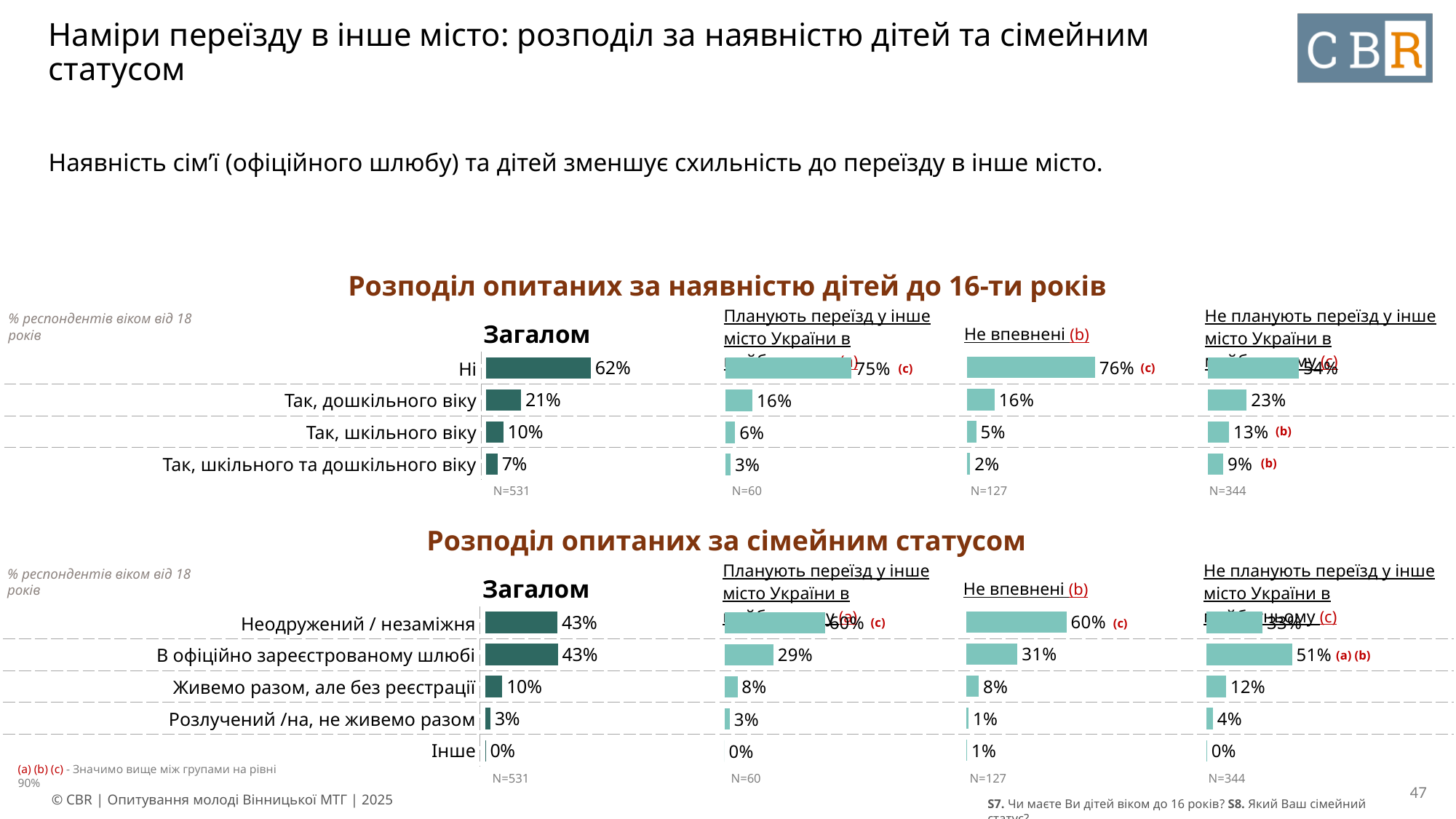
In the chart 'Розподіл опитаних за наявністю дітей до 16-ти років', what is the value for 'Ні' in the 'Загалом' column? 62% What kind of chart is used on this slide? Bar chart In the chart 'Розподіл опитаних за сімейним статусом', what is the difference between 'В офіційно зареєстрованому шлюбі' in the 'Не планують переїзд' column and in the 'Планують переїзд' column? 22% In the chart 'Розподіл опитаних за наявністю дітей до 16-ти років', what is the value for 'Так, дошкільного віку' in the 'Не планують переїзд' column? 23% In the chart 'Розподіл опитаних за наявністю дітей до 16-ти років', how many categories are listed? 4 In the chart 'Розподіл опитаних за сімейним статусом', what is the value for 'В офіційно зареєстрованому шлюбі' in the 'Не планують переїзд' column? 51% In the chart 'Розподіл опитаних за наявністю дітей до 16-ти років', which category has the lowest value in the 'Не впевнені' column? Так, шкільного та дошкільного віку In the chart 'Розподіл опитаних за сімейним статусом', which is larger in the 'Планують переїзд' column: 'В офіційно зареєстрованому шлюбі' or 'Живемо разом, але без реєстрації'? В офіційно зареєстрованому шлюбі In the chart 'Розподіл опитаних за наявністю дітей до 16-ти років', what is the value for 'Ні' in the 'Не впевнені' column? 76% In the chart 'Розподіл опитаних за сімейним статусом', what is the value for 'Неодружений / незаміжня' in the 'Не впевнені' column? 60% In the chart 'Розподіл опитаних за наявністю дітей до 16-ти років', what is the difference between 'Так, шкільного віку' in the 'Не планують переїзд' column and in the 'Планують переїзд' column? 7% In the chart 'Розподіл опитаних за сімейним статусом', how many categories are listed? 5